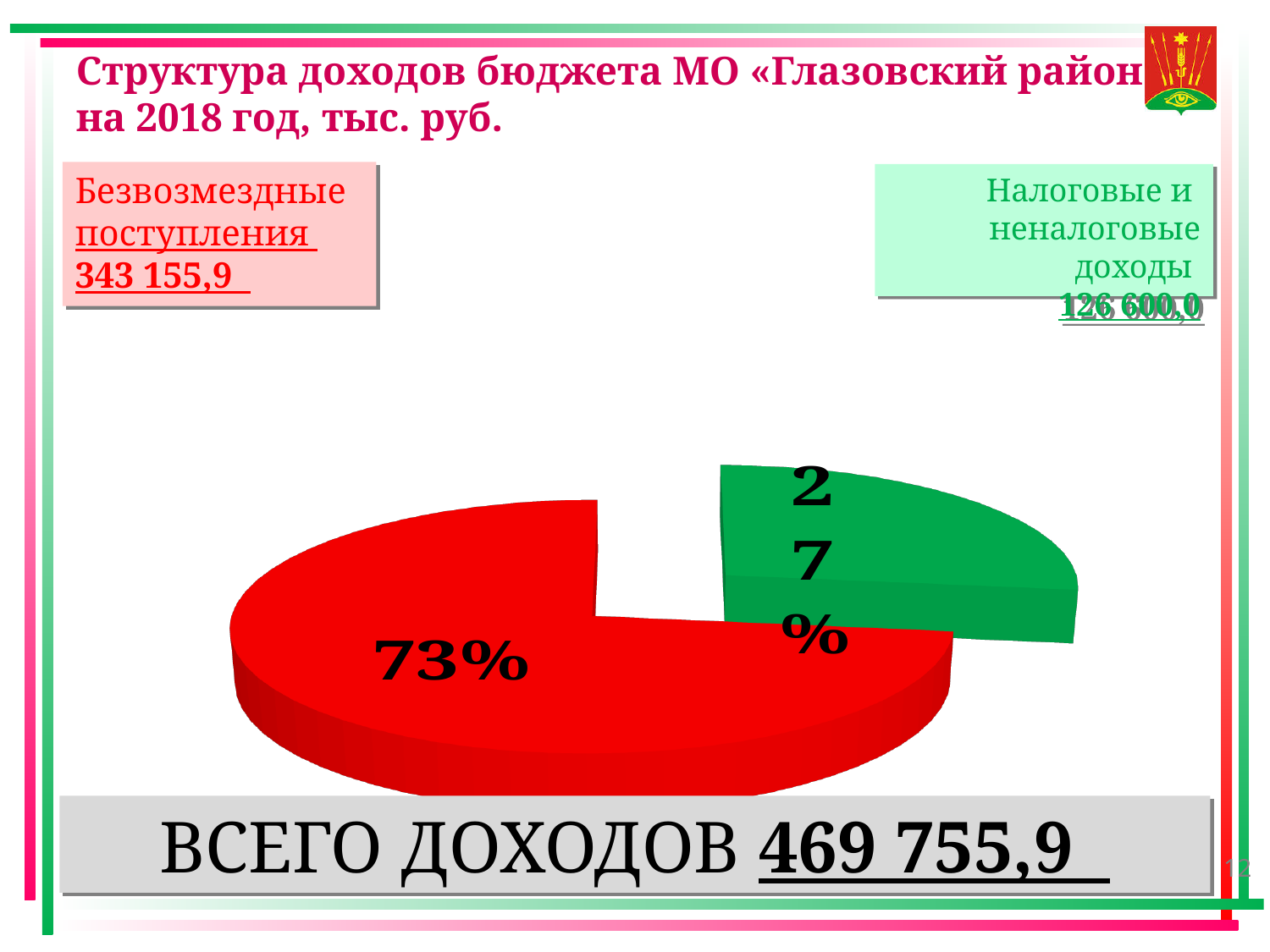
What is the total of all revenues (ВСЕГО ДОХОДОВ) shown on the slide? 469 755,9 Which category has the largest share of the pie? Безвозмездные поступления What colour is the slice representing Налоговые и неналоговые доходы? green What is the value shown for Налоговые и неналоговые доходы? 126 600,0 Which is larger: the share for Безвозмездные поступления or the share for Налоговые и неналоговые доходы? Безвозмездные поступления What share of the pie does the red slice (Безвозмездные поступления) represent? 73% How many slices does the pie chart have? 2 What is the difference between the value for Безвозмездные поступления and the value for Налоговые и неналоговые доходы? 216 555,9 What kind of chart is shown on the slide? pie chart What is the value shown for Безвозмездные поступления? 343 155,9 What share of the pie does the green slice (Налоговые и неналоговые доходы) represent? 27% Which category has the smallest share of the pie? Налоговые и неналоговые доходы